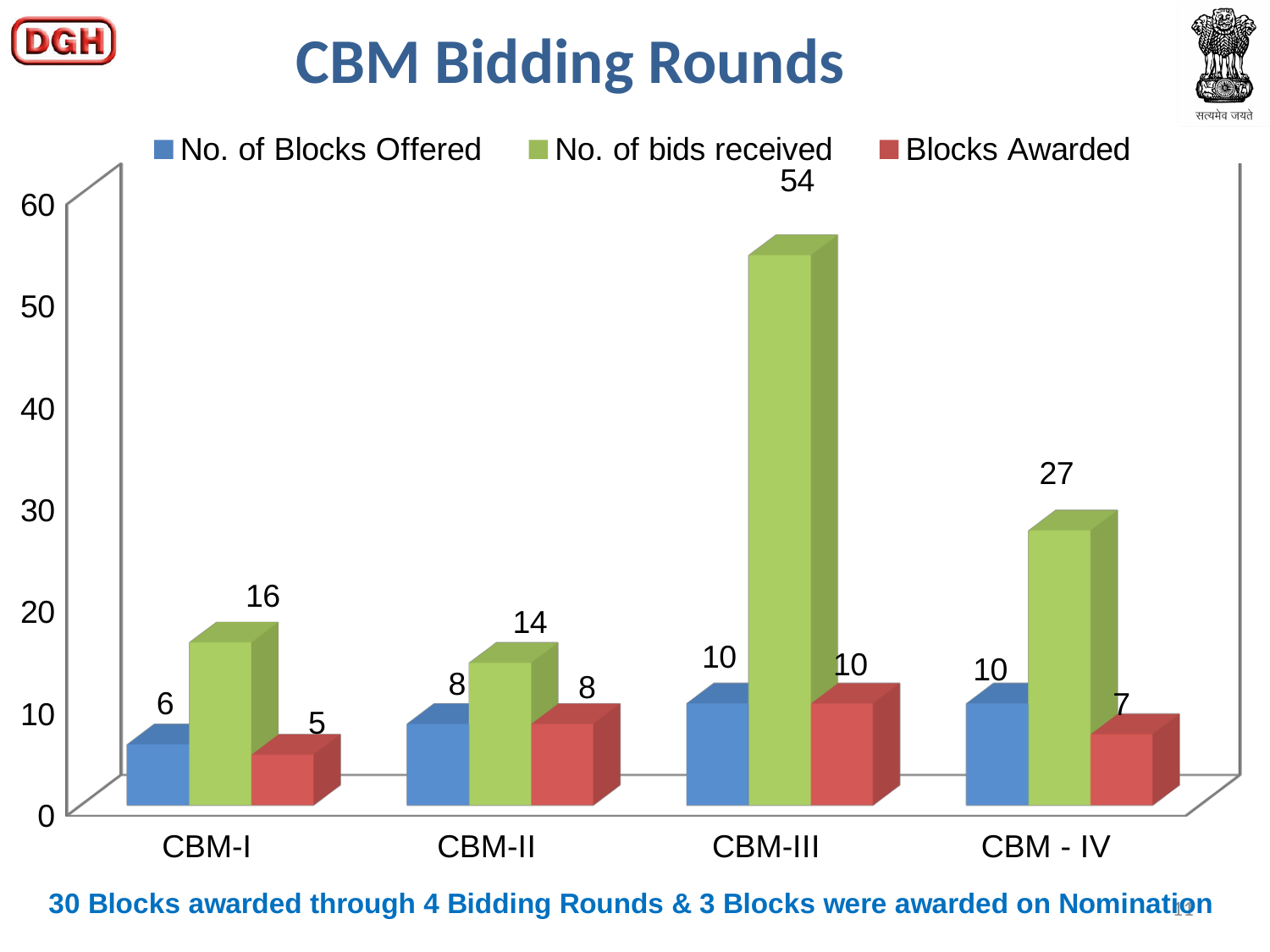
How many bids were received in CBM-III? 54 What is the title of the chart? CBM Bidding Rounds Is the number of bids received in CBM - IV greater or less than 30? less How many blocks were awarded in CBM-I? 5 How many bidding rounds are shown on the x axis? 4 Which bidding round had the highest number of bids received? CBM-III What is the difference between the number of bids received and the number of blocks awarded in CBM - IV? 20 What kind of chart is shown on the slide? bar chart How many series does the legend list? 3 Which is larger: the number of bids received in CBM-I or in CBM-II? CBM-I How many blocks were offered in CBM-II? 8 Which bidding round had the lowest number of blocks offered? CBM-I